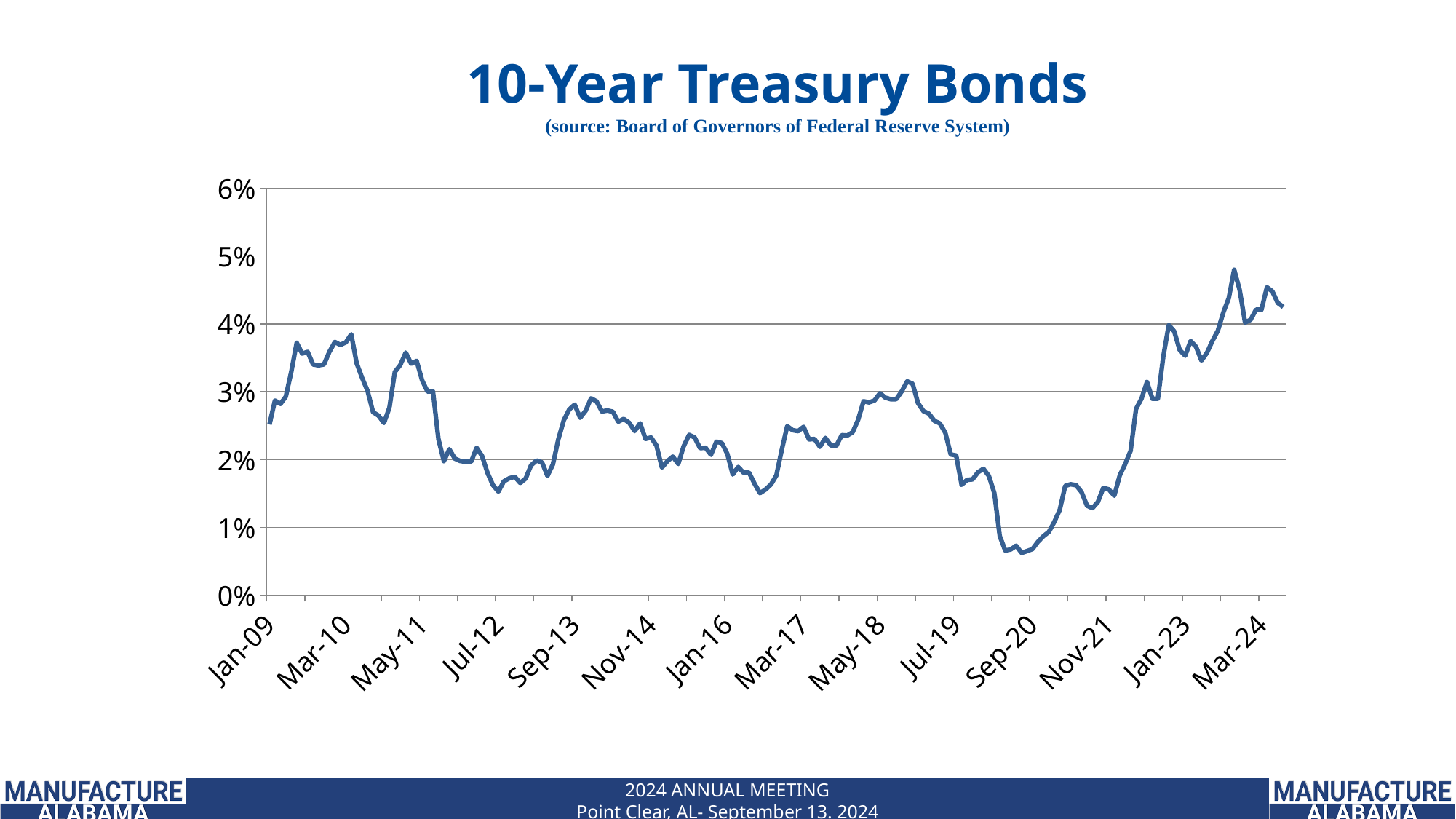
Is the value at Nov-21 greater or less than 2%? less Near which x-axis label does the line reach its lowest value? Sep-20 Is the value at Mar-24 greater or less than 4%? greater Is the value at Jul-12 greater or less than 2%? less Does the line generally rise or fall between Sep-20 and Mar-24? rise What kind of chart is shown on the slide? line chart What source is cited under the chart title? Board of Governors of Federal Reserve System What is the title of the chart? 10-Year Treasury Bonds How many date labels are shown on the x axis? 14